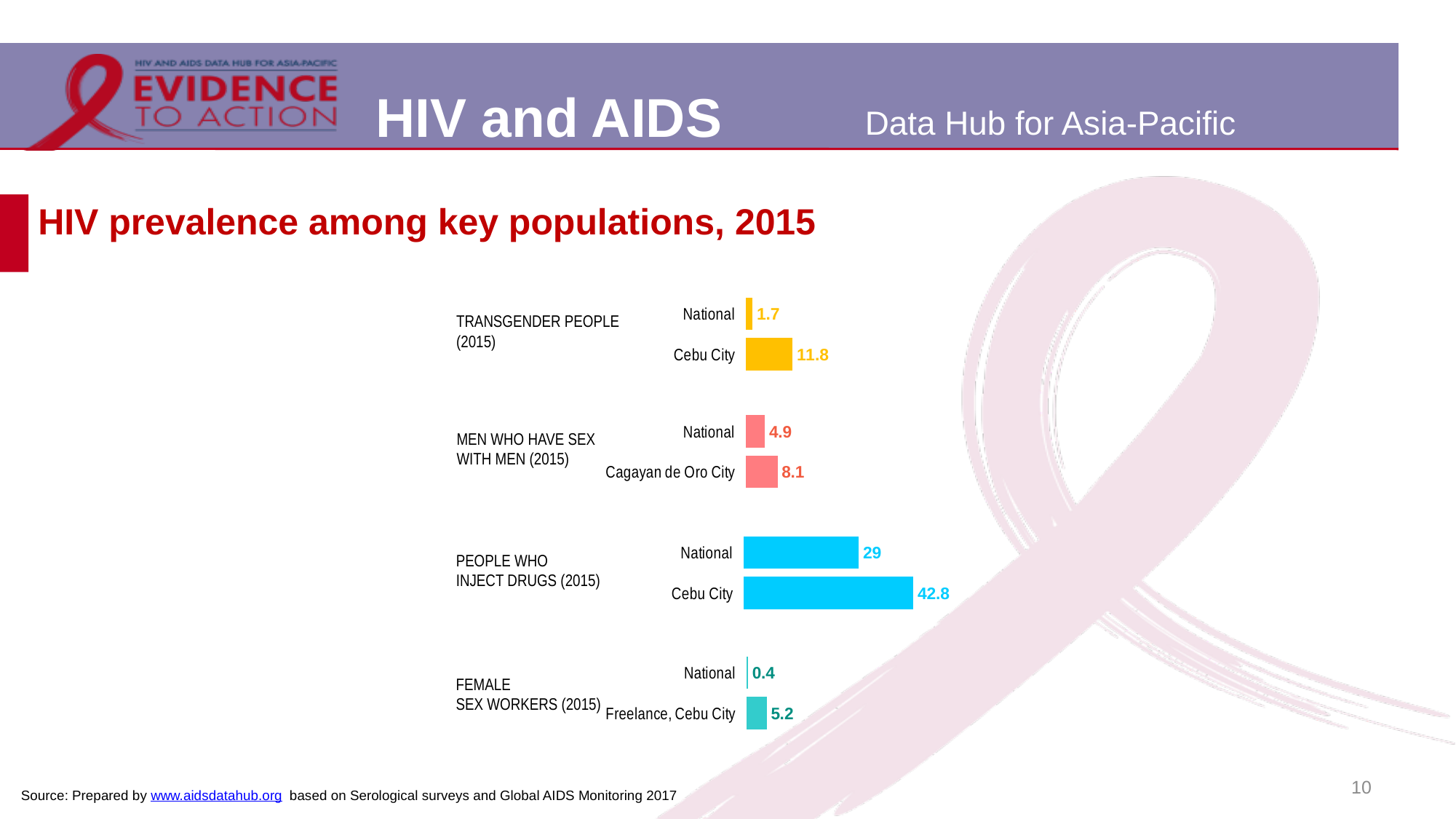
What is the difference between the Cebu City and national values for people who inject drugs? 13.8 Which bar has the lowest value on the chart? National, female sex workers (0.4) What is the national HIV prevalence value among female sex workers? 0.4 How many bars are plotted on the chart? 8 Which is larger: the national value for men who have sex with men or the Freelance, Cebu City value for female sex workers? Freelance, Cebu City value for female sex workers What is the HIV prevalence value for Cebu City among transgender people? 11.8 What is the difference between the Cebu City and national values for transgender people? 10.1 What is the HIV prevalence value for Cagayan de Oro City among men who have sex with men? 8.1 Which bar has the highest value on the chart? Cebu City, people who inject drugs (42.8) What kind of chart is shown on the slide? Bar chart What is the national HIV prevalence value among men who have sex with men? 4.9 What is the HIV prevalence value for Cebu City among people who inject drugs? 42.8